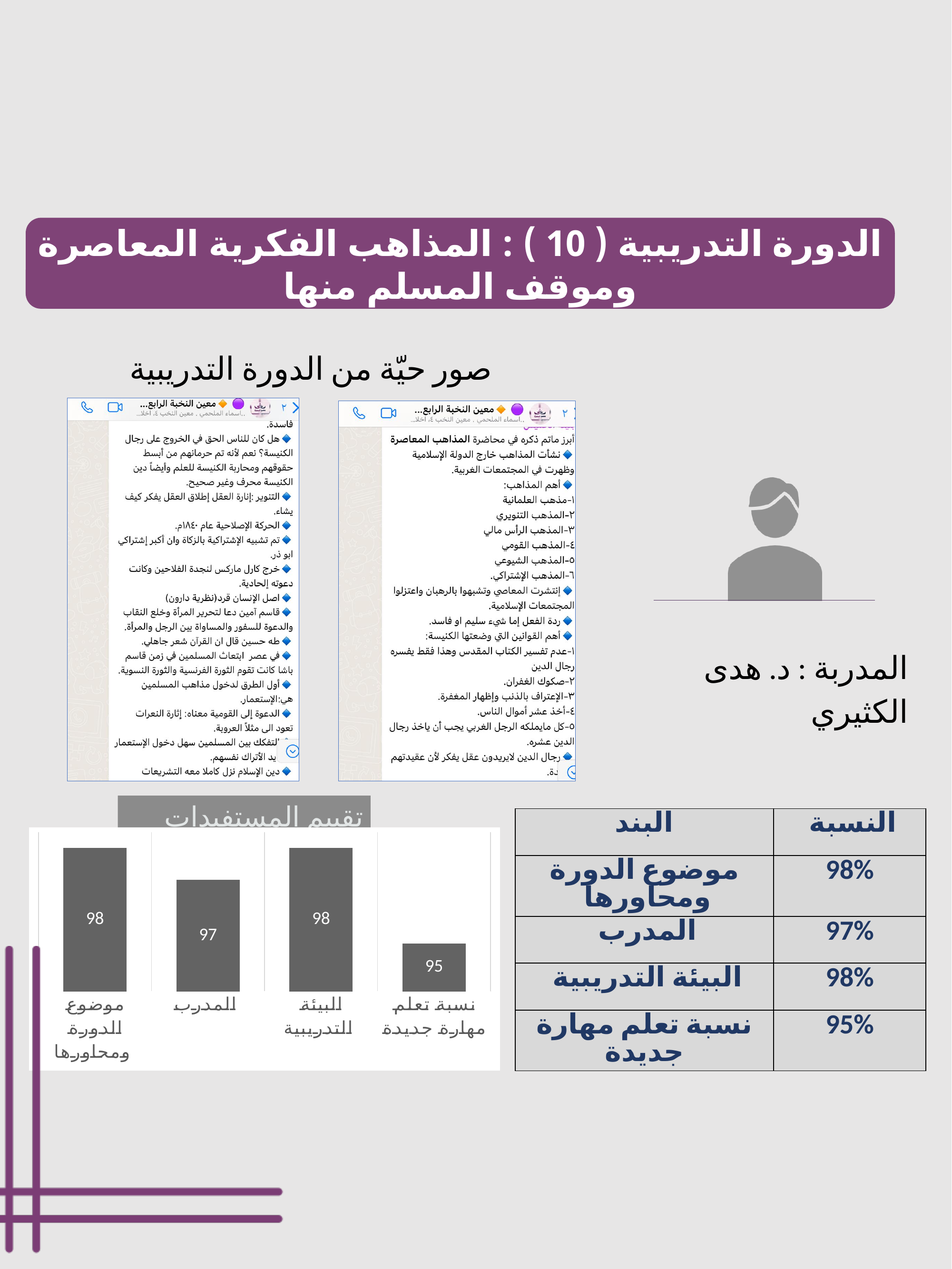
What is the difference between the values for البيئة التدريبية and نسبة تعلم مهارة جديدة in the bar chart? 3 What kind of chart is shown on the slide? Bar chart What value is shown for المدرب in the bar chart? 97 What value is shown for نسبة تعلم مهارة جديدة in the bar chart? 95 What is the difference between the values for المدرب and نسبة تعلم مهارة جديدة in the bar chart? 2 In the bar chart, which is larger: the value for المدرب or the value for نسبة تعلم مهارة جديدة? المدرب What is the title of the bar chart? تقييم المستفيدات What value is shown for موضوع الدورة ومحاورها in the bar chart? 98 Which category has the lowest value in the bar chart? نسبة تعلم مهارة جديدة What value is shown for البيئة التدريبية in the bar chart? 98 How many categories are shown in the bar chart? 4 In the bar chart, which is larger: the value for البيئة التدريبية or the value for المدرب? البيئة التدريبية